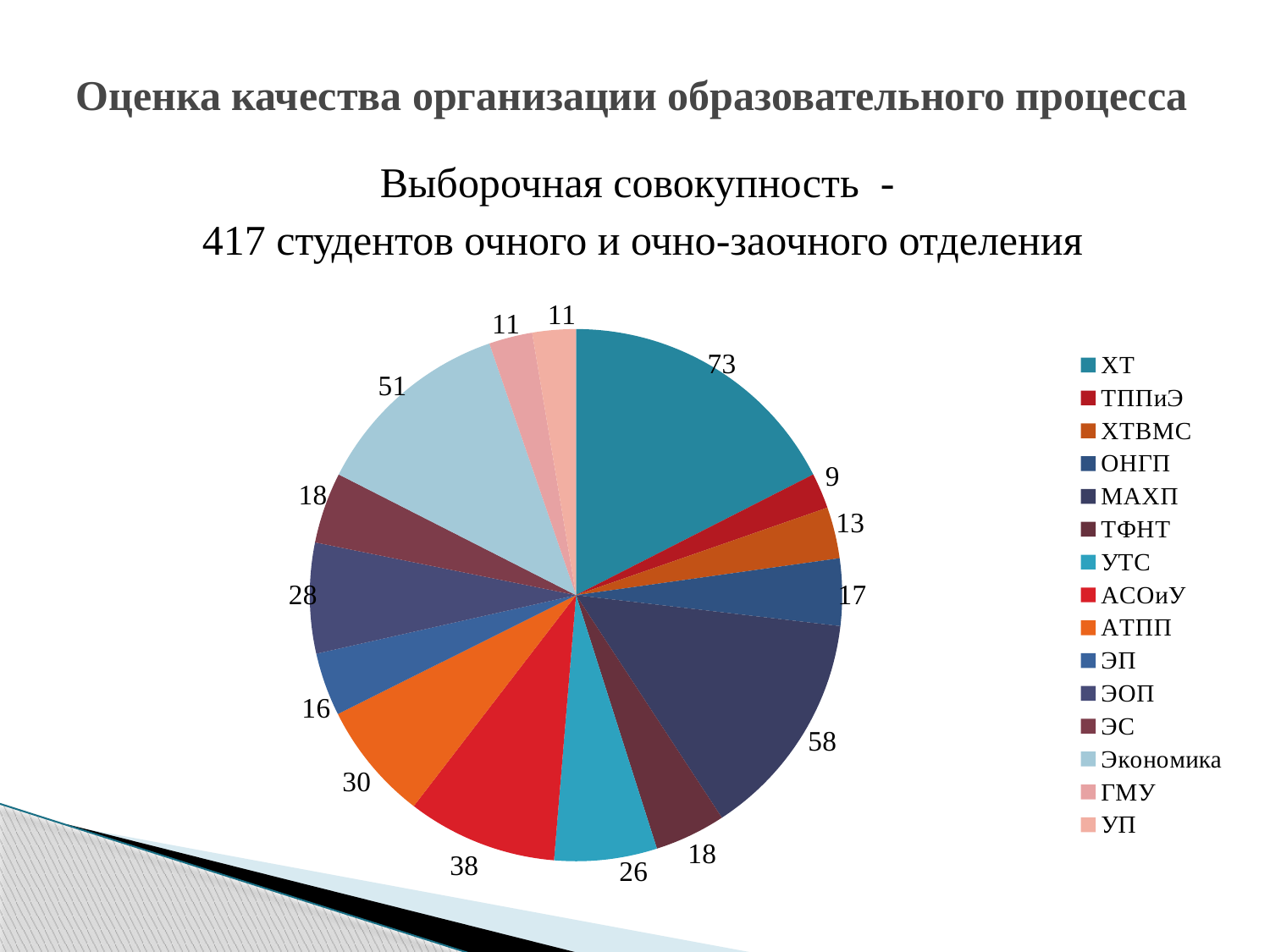
What is the value for МАХП in the pie chart? 58 Which category has the largest slice in the pie chart? ХТ What is the title of the slide above the chart? Оценка качества организации образовательного процесса How many categories does the legend of the pie chart list? 15 What is the value for АСОиУ in the pie chart? 38 What is the value for ХТ in the pie chart? 73 What is the value for Экономика in the pie chart? 51 Which is larger, the value for АТПП or the value for УТС? АТПП What type of chart is shown on the slide? pie chart Which category has the smallest slice in the pie chart? ТППиЭ What is the total of all slices in the pie chart? 417 What is the difference between the values for ХТ and МАХП? 15